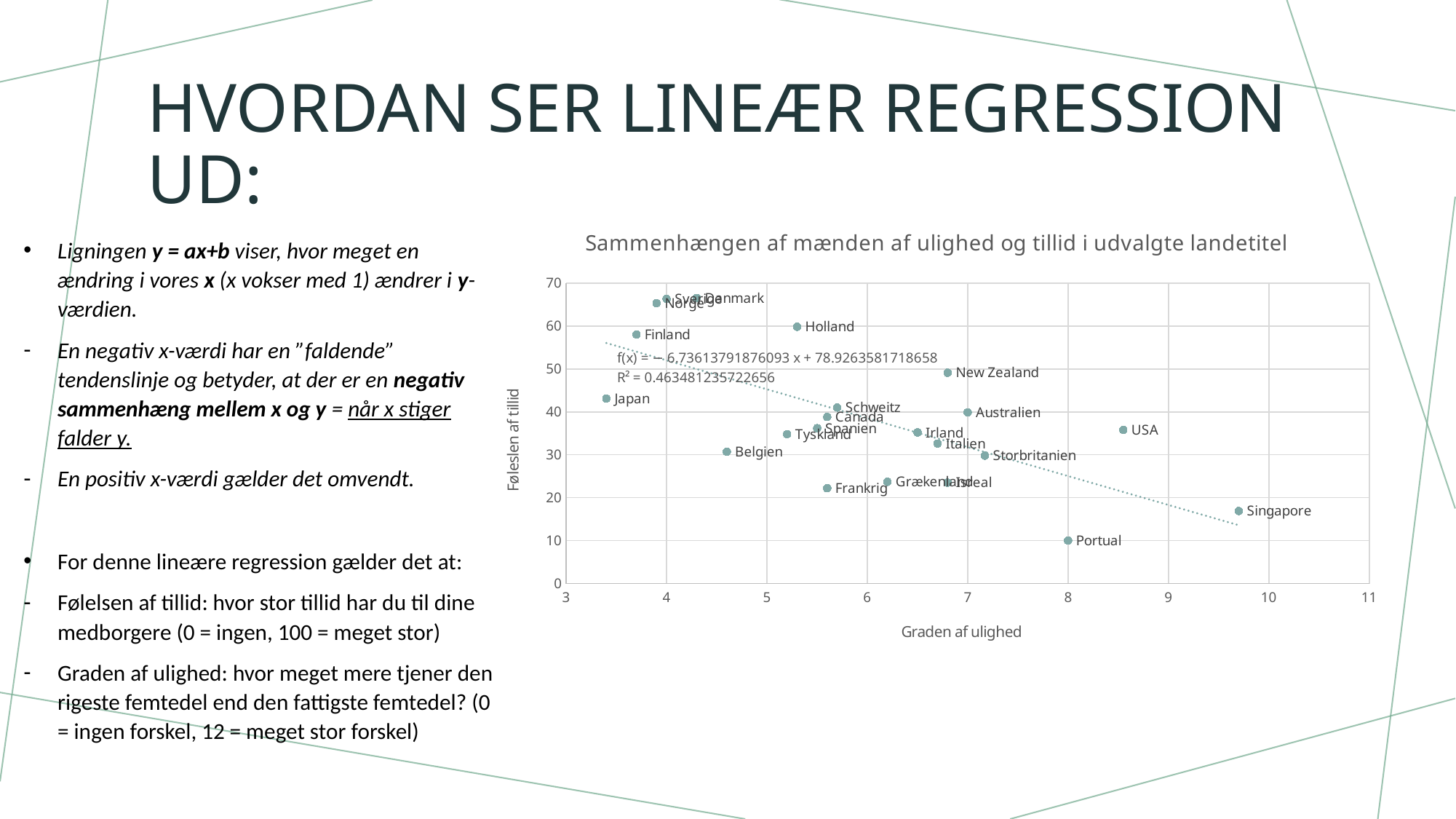
Which has a higher 'Graden af ulighed' value, USA or Japan? USA Which country has the lowest value on the 'Føleslen af tillid' axis? Portual What kind of chart is shown on the slide? scatter chart What is the title of the chart? Sammenhængen af mænden af ulighed og tillid i udvalgte landetitel What is the R² value printed on the chart? 0.463481235722656 Which country has the lowest value on the 'Graden af ulighed' axis? Japan Is the 'Føleslen af tillid' value for Japan greater or less than 40? greater Does the trendline rise or fall as 'Graden af ulighed' increases? fall Which country has the highest value on the 'Graden af ulighed' axis? Singapore Is the 'Føleslen af tillid' value for Singapore greater or less than 20? less Which has a higher 'Føleslen af tillid' value, Holland or Belgien? Holland Is the 'Føleslen af tillid' value for Holland greater or less than 50? greater